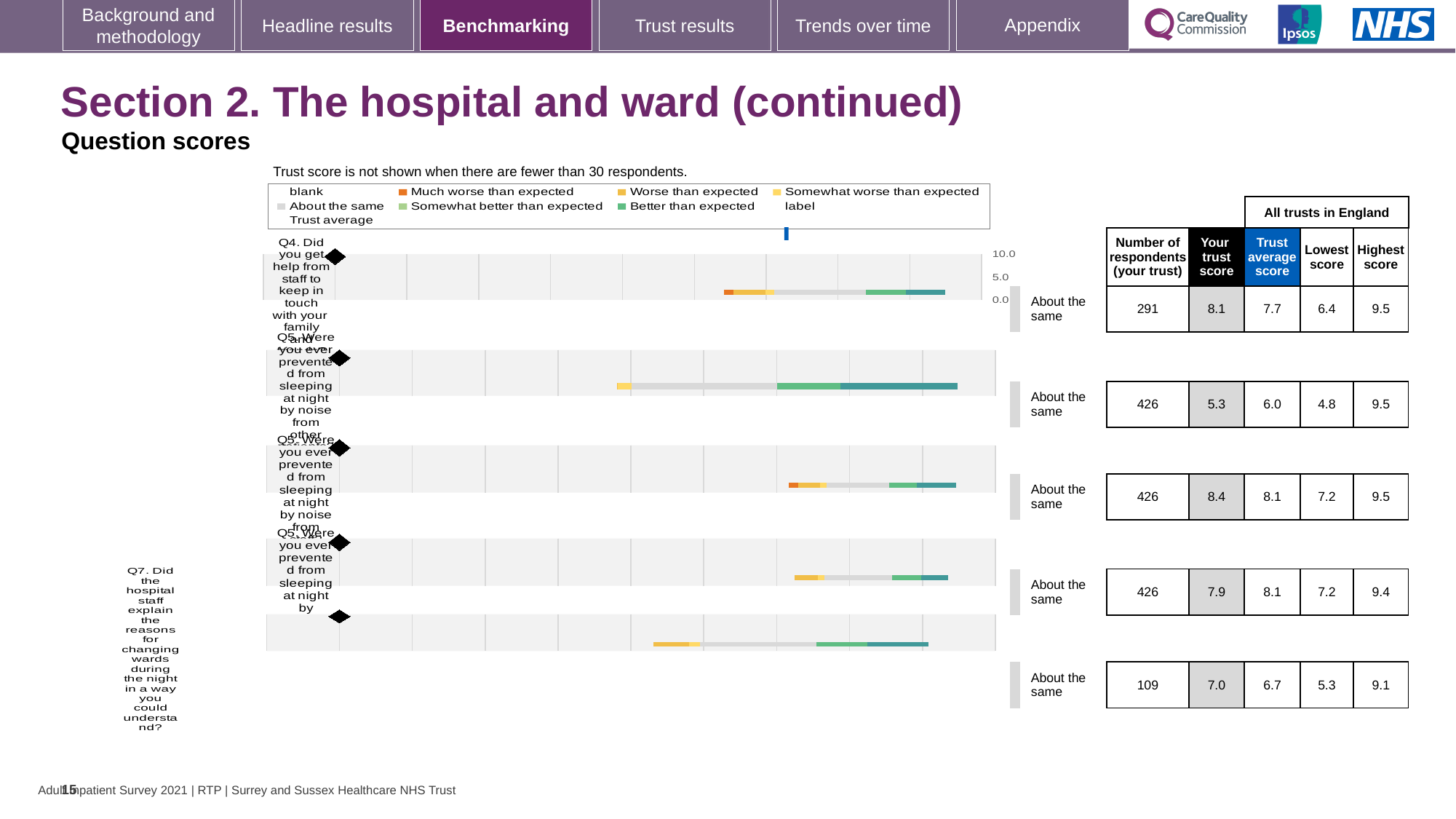
What is the highest 'Your trust score' value shown in the table? 8.4 What is the number of respondents for Q4 (help from staff to keep in touch with family and friends)? 291 In the legend, which category is shown in dark orange? Much worse than expected What is the trust average score for Q7 (explaining reasons for changing wards during the night)? 6.7 For Q4, which is larger: the 'Your trust score' or the trust average score? Your trust score How many question rows are plotted in the chart? 5 What is the 'Your trust score' value for Q4? 8.1 What is the lowest score across all trusts in England for Q7? 5.3 What kind of chart is used to show the question scores on this slide? bar chart What benchmark label is shown next to every question row in the chart? About the same For Q4, what is the difference between the highest score and the lowest score across all trusts in England? 3.1 Which question row has the lowest number of respondents? Q7